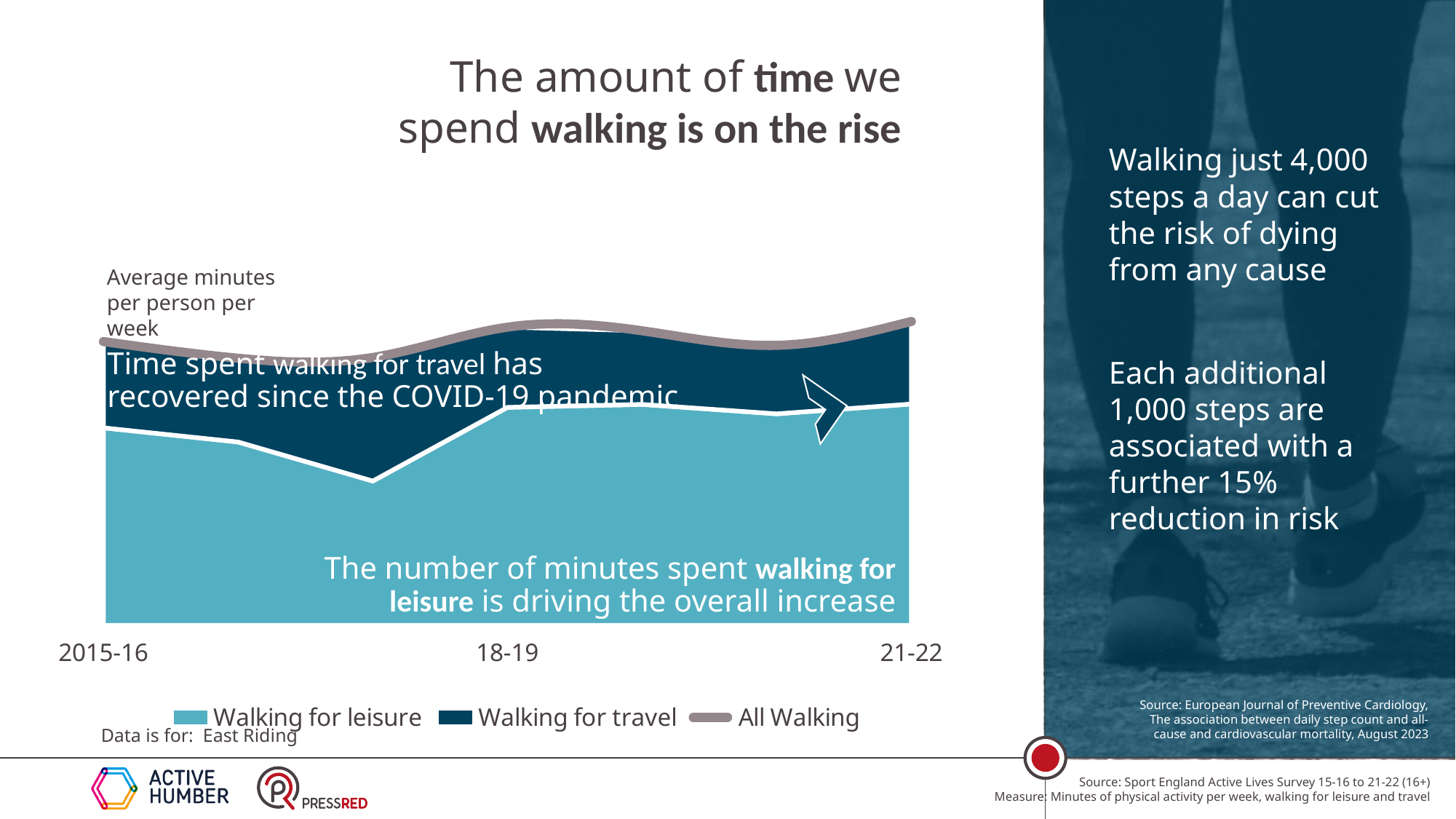
Which series is shown as a grey line on the chart? All Walking What is the last year label on the chart's x axis? 21-22 Does the All Walking line rise or fall overall from 2015-16 to 21-22? Rise How many series does the chart's legend list? 3 What are the three series listed in the chart's legend? Walking for leisure, Walking for travel, All Walking Which series is larger throughout the chart, Walking for leisure or Walking for travel? Walking for leisure What kind of chart is shown on the slide? Area chart Which area does the slide say is driving the overall increase in walking minutes? Walking for leisure What is the first year label on the chart's x axis? 2015-16 Which is larger at 21-22, the area for Walking for leisure or the area for Walking for travel? Walking for leisure